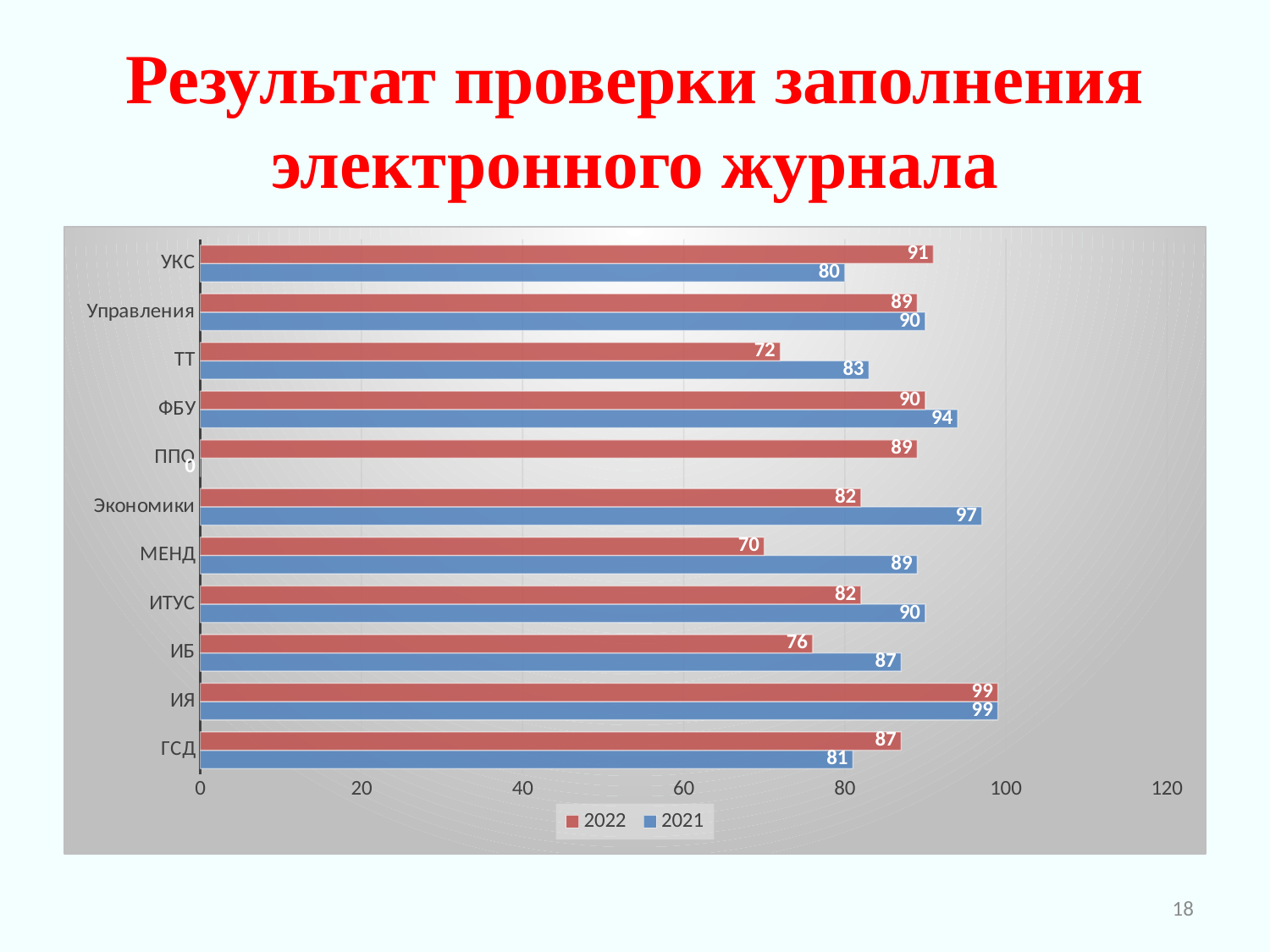
Which category has the highest 2022 value? ИЯ Which is larger for ТТ, the 2022 value or the 2021 value? 2021 How many categories are shown on the chart? 11 Which colour represents the 2021 series? Blue How many series does the legend list? 2 What is the 2021 value for Экономики? 97 What is the 2022 value for УКС? 91 What is the 2022 value for МЕНД? 70 What kind of chart is shown on the slide? Bar chart What is the 2021 value for ППО? 0 Which category has the lowest 2022 value? МЕНД What is the difference between the 2021 and 2022 values for Экономики? 15